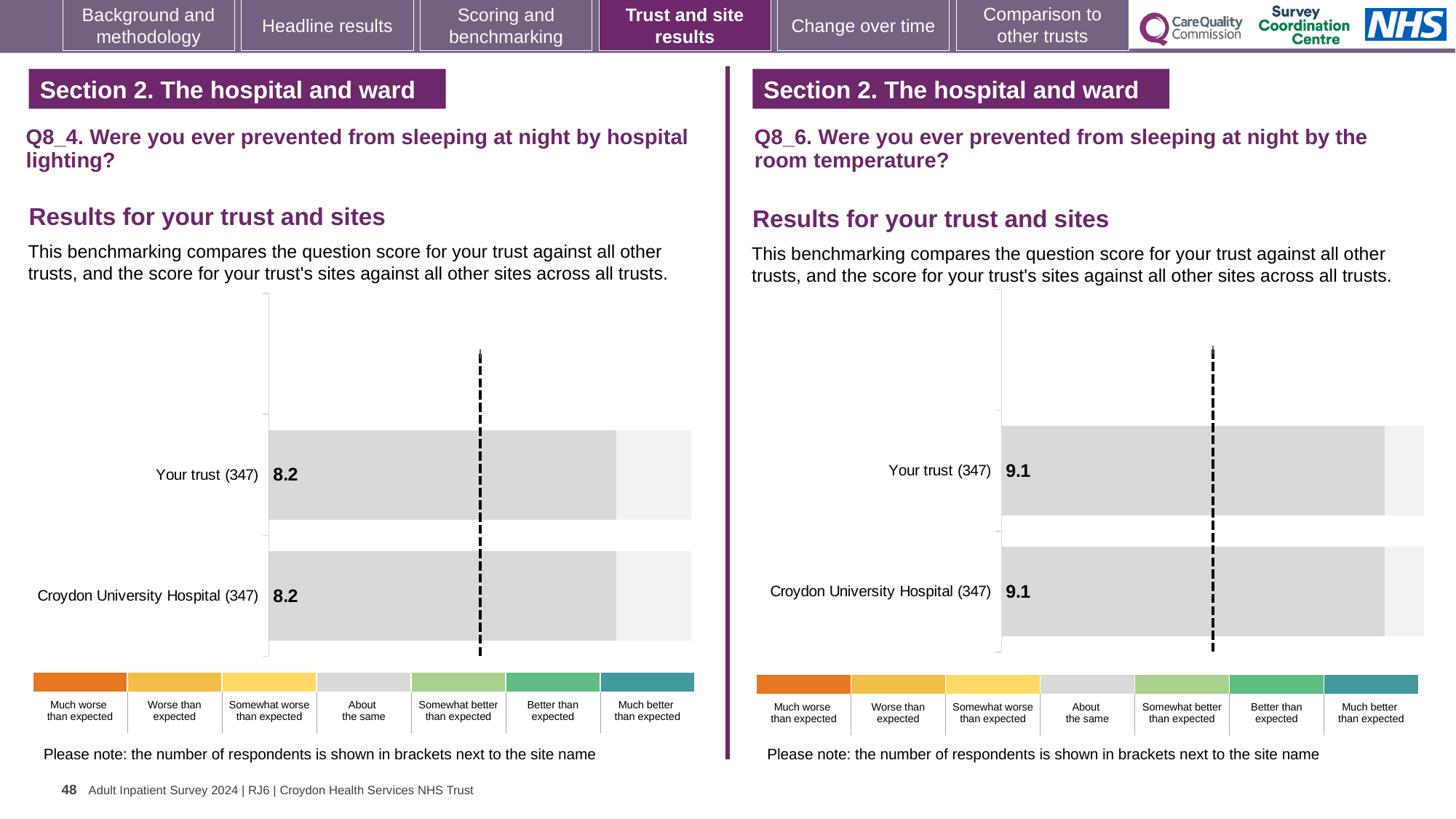
On the Q8_6 room temperature chart, how many respondents are shown in brackets next to Croydon University Hospital? 347 On the Q8_4 hospital lighting chart, which benchmark category does the grey colour of the bars correspond to in the legend? About the same How many categories does the colour legend below the Q8_6 room temperature chart list? 7 On the Q8_6 room temperature chart, how many bars are plotted? 2 On the Q8_4 hospital lighting chart, what is the score for Your trust? 8.2 On the Q8_6 room temperature chart, what is the score for Your trust? 9.1 What kind of chart is shown on the left-hand Q8_4 chart? Bar chart On the Q8_4 hospital lighting chart, how many respondents are shown in brackets next to Your trust? 347 On the Q8_4 hospital lighting chart, what is the score for Croydon University Hospital? 8.2 On the Q8_4 hospital lighting chart, what is the difference between the Your trust score and the Croydon University Hospital score? 0.0 On the Q8_6 room temperature chart, what is the score for Croydon University Hospital? 9.1 Is the Your trust score on the Q8_6 room temperature chart larger or smaller than the Your trust score on the Q8_4 hospital lighting chart? Larger